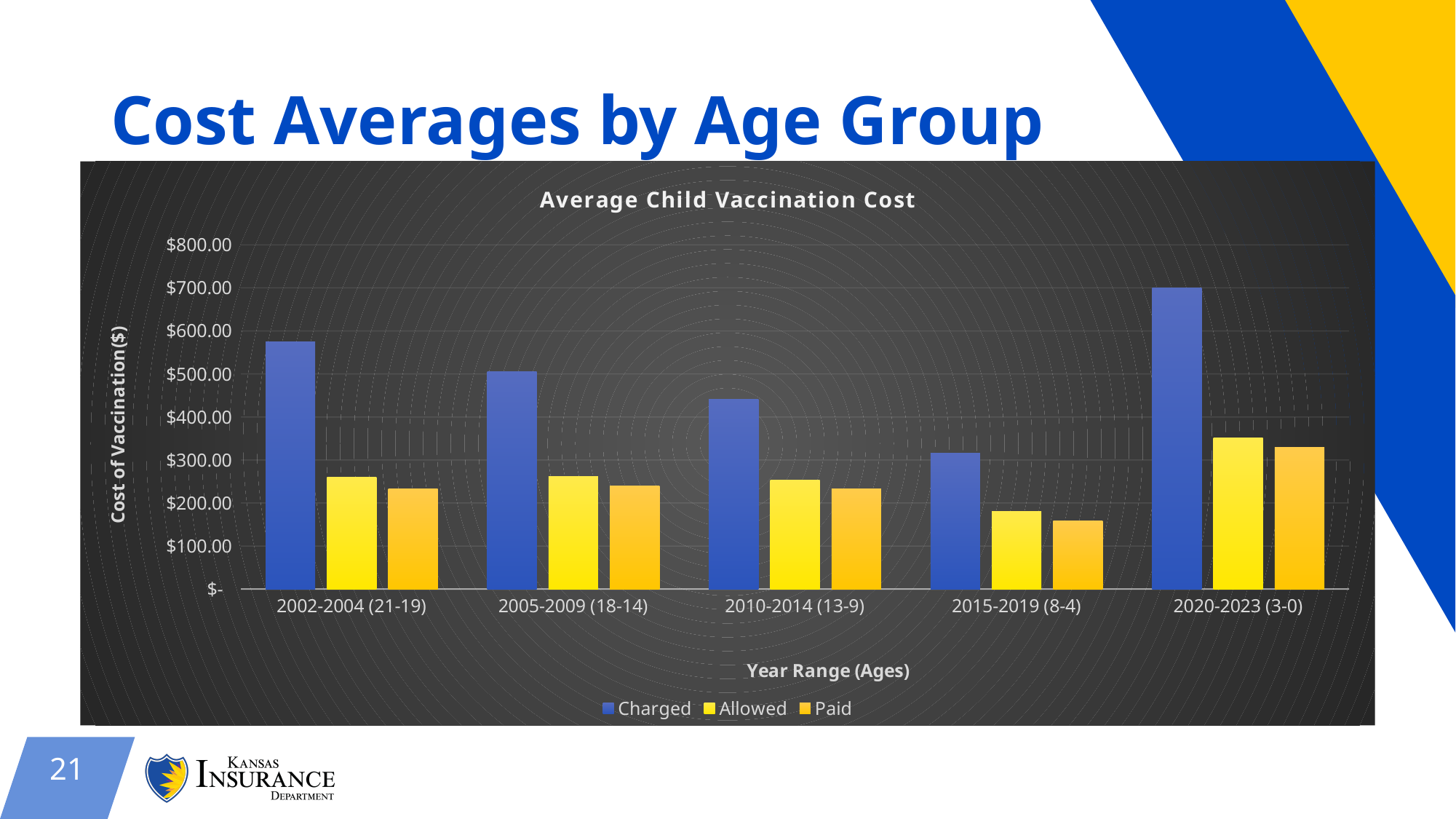
Which year range has the highest Allowed value? 2020-2023 (3-0) How many year-range categories are shown on the x axis? 5 How many series does the legend list? 3 Which is larger, the Charged value for 2002-2004 (21-19) or the Charged value for 2005-2009 (18-14)? 2002-2004 (21-19) Which year range has the lowest Charged value? 2015-2019 (8-4) Is the Allowed value for 2015-2019 (8-4) greater or less than $200.00? less What kind of chart is shown on the slide? bar chart Which year range has the lowest Paid value? 2015-2019 (8-4) What is the title of the chart? Average Child Vaccination Cost Which year range has the highest Charged value? 2020-2023 (3-0) Is the Charged value for 2002-2004 (21-19) greater or less than $500.00? greater Is the Charged value for 2020-2023 (3-0) greater or less than $600.00? greater